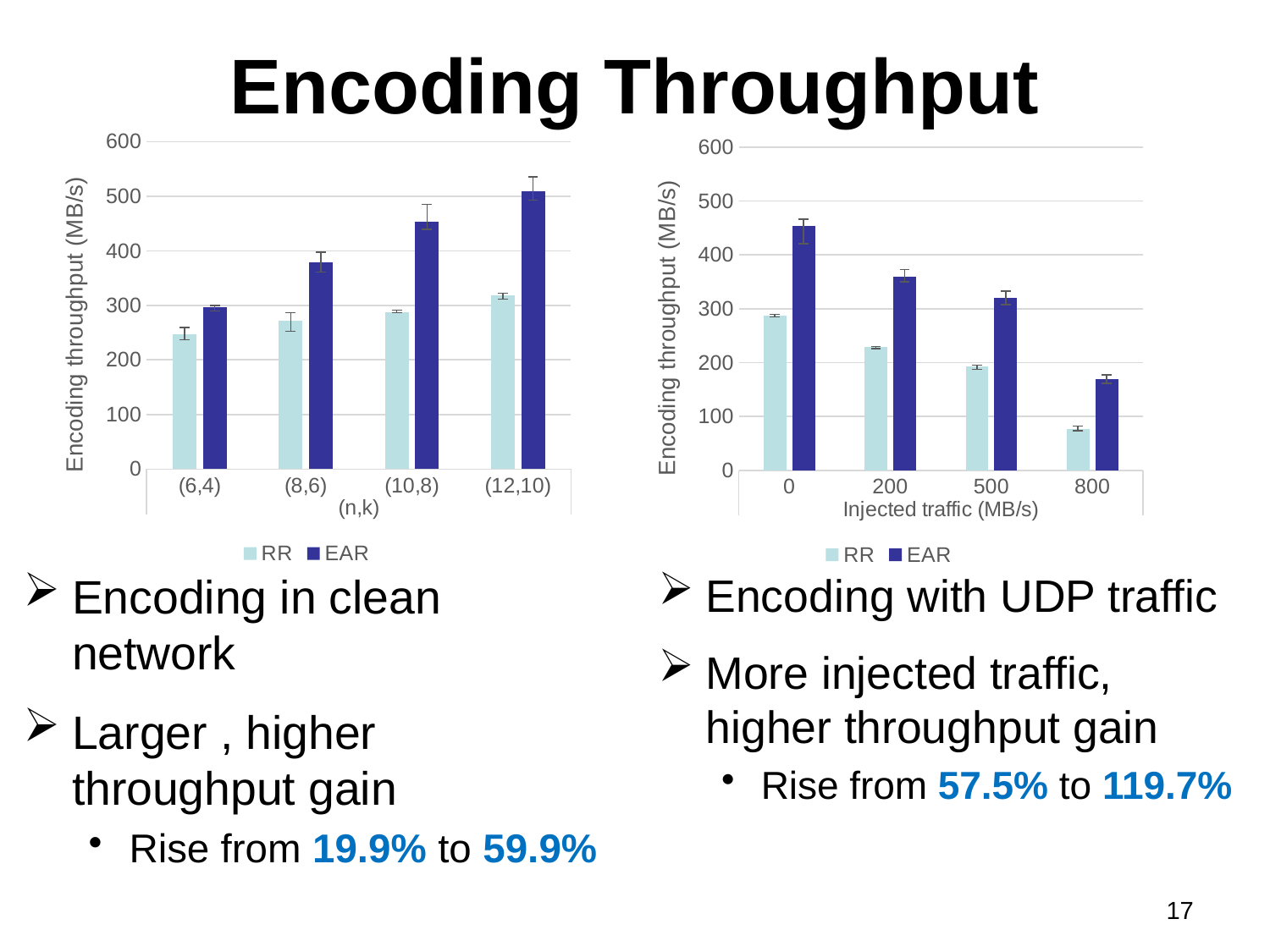
In the left chart, which (n,k) category has the lowest RR throughput? (6,4) How many series does the legend of the right chart list? 2 What kind of chart is the left chart on the slide? bar chart In the right chart, which is larger at 500 MB/s injected traffic, RR or EAR? EAR In the right chart, which injected traffic level has the lowest RR throughput? 800 How many (n,k) categories are shown on the x axis of the left chart? 4 In the right chart, is the EAR value at 0 MB/s injected traffic greater or less than 400? greater In the left chart, is the RR value for (8,6) greater or less than 300? less In the right chart, do the EAR values rise or fall as injected traffic increases? fall In the left chart, which (n,k) category has the highest EAR throughput? (12,10) What is the x-axis label of the right chart? Injected traffic (MB/s)